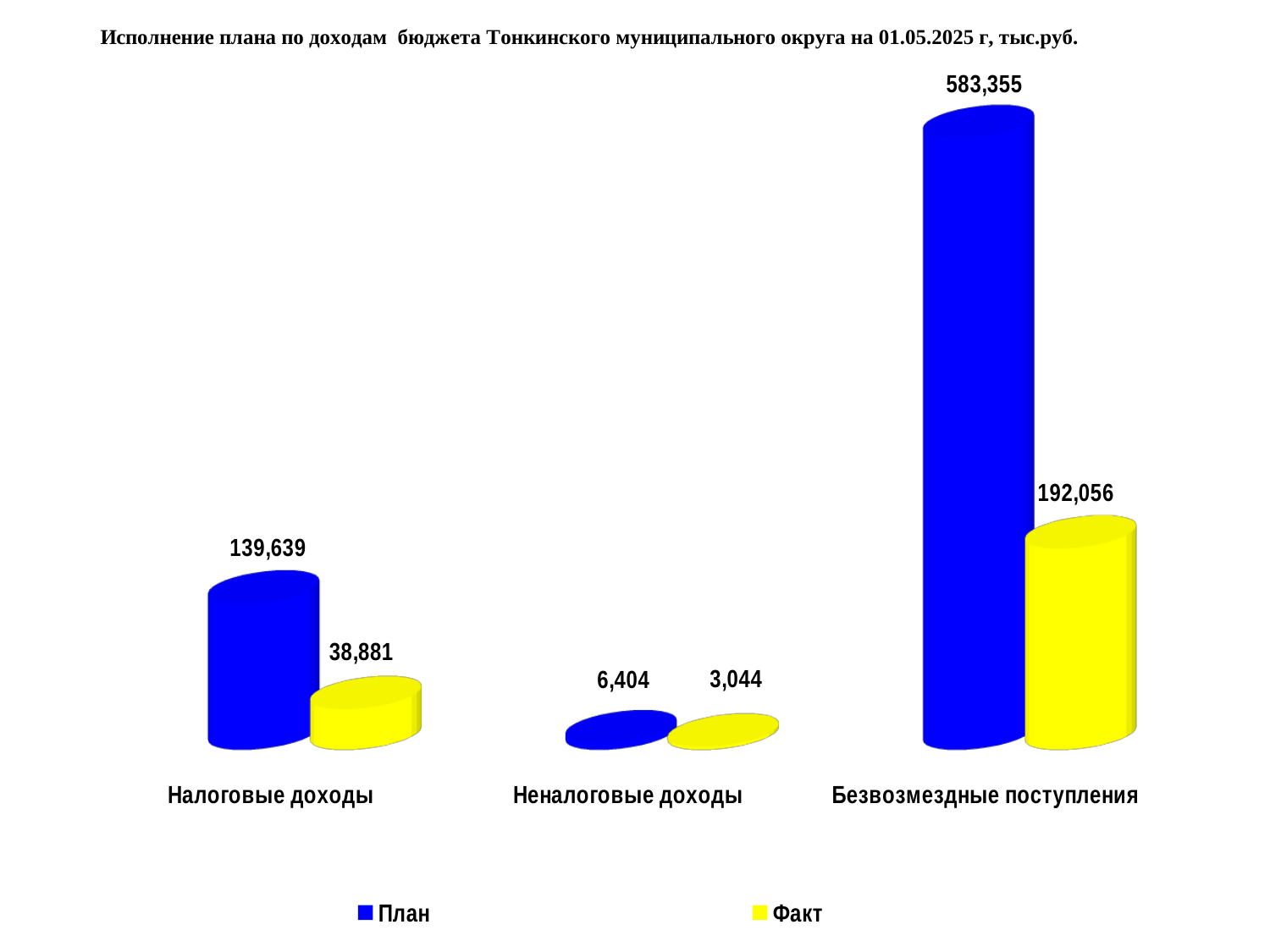
What is the Факт value for Безвозмездные поступления? 192,056 Which category has the highest План value? Безвозмездные поступления What is the difference between the План and Факт values for Налоговые доходы? 100,758 What kind of chart is shown on the slide? Bar chart Which colour represents the Факт series? Yellow How many categories are shown on the x axis? 3 Which is larger: the Факт value for Налоговые доходы or the План value for Неналоговые доходы? Факт value for Налоговые доходы What is the План value for Налоговые доходы? 139,639 How many series does the legend list? 2 What is the difference between the План and Факт values for Безвозмездные поступления? 391,299 Which category has the lowest Факт value? Неналоговые доходы What is the Факт value for Неналоговые доходы? 3,044